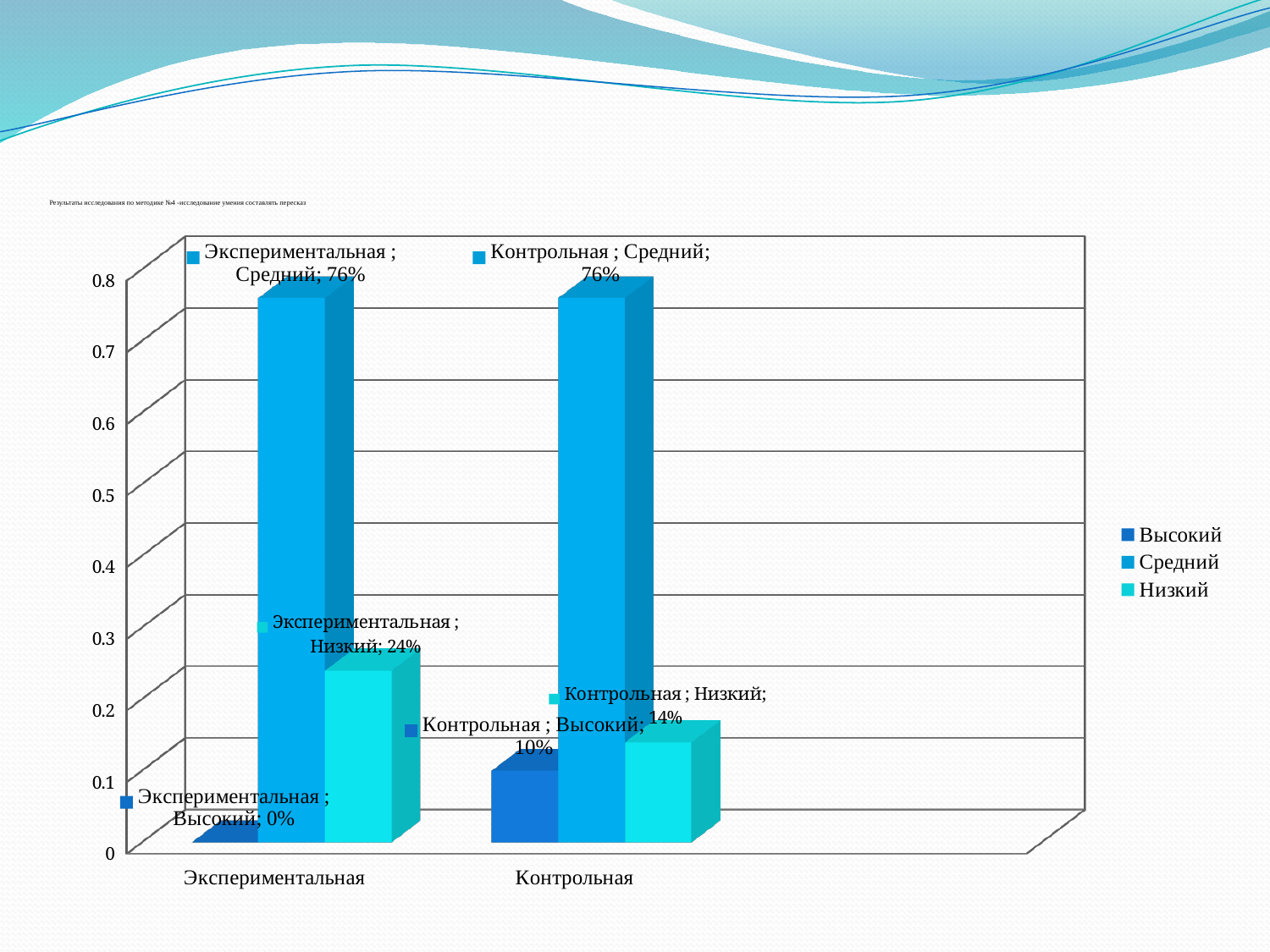
How many series does the legend list? 3 Which level has the highest value in the Экспериментальная group? Средний What is the value for Низкий in the Экспериментальная group? 24% What is the value for Высокий in the Контрольная group? 10% How many groups are shown on the x axis? 2 What kind of chart is shown on the slide? Bar chart What is the value for Низкий in the Контрольная group? 14% What is the value for Средний in the Экспериментальная group? 76% What is the difference between the Низкий values of the Экспериментальная and Контрольная groups? 10% Which level has the lowest value in the Контрольная group? Высокий Which is larger: Низкий in the Экспериментальная group or Низкий in the Контрольная group? Экспериментальная What is the value for Высокий in the Экспериментальная group? 0%